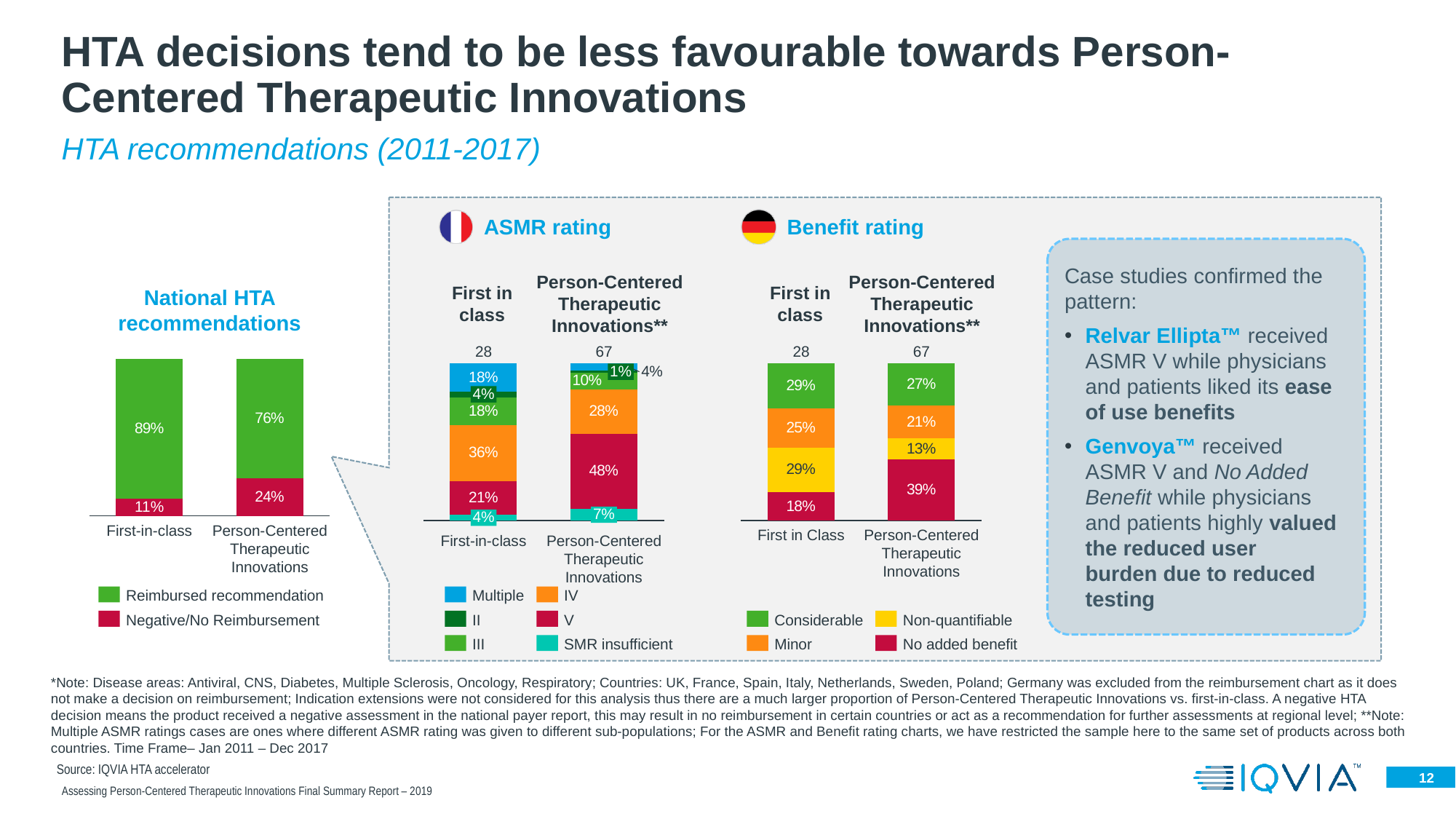
In the Benefit rating chart, what percentage of Person-Centered Therapeutic Innovations received a No added benefit rating? 39% In the National HTA recommendations chart, what percentage of Person-Centered Therapeutic Innovations received a Negative/No Reimbursement decision? 24% In the National HTA recommendations chart, what percentage of First-in-class products received a reimbursed recommendation? 89% In the ASMR rating chart, how many products are in the Person-Centered Therapeutic Innovations sample? 67 How many series does the legend of the National HTA recommendations chart list? 2 In the Benefit rating chart, which group has the larger share of Non-quantifiable ratings, First in Class or Person-Centered Therapeutic Innovations? First in Class In the ASMR rating chart, what percentage of Person-Centered Therapeutic Innovations received an ASMR V rating? 48% In the Benefit rating chart, what is the difference between the No added benefit shares for Person-Centered Therapeutic Innovations and First in Class? 21 percentage points In the National HTA recommendations chart, what is the difference between the reimbursed recommendation shares for First-in-class and Person-Centered Therapeutic Innovations? 13 percentage points What kind of chart is the ASMR rating chart? Stacked bar chart How many series does the legend of the ASMR rating chart list? 6 In the ASMR rating chart, what percentage of First-in-class products received an ASMR IV rating? 36%